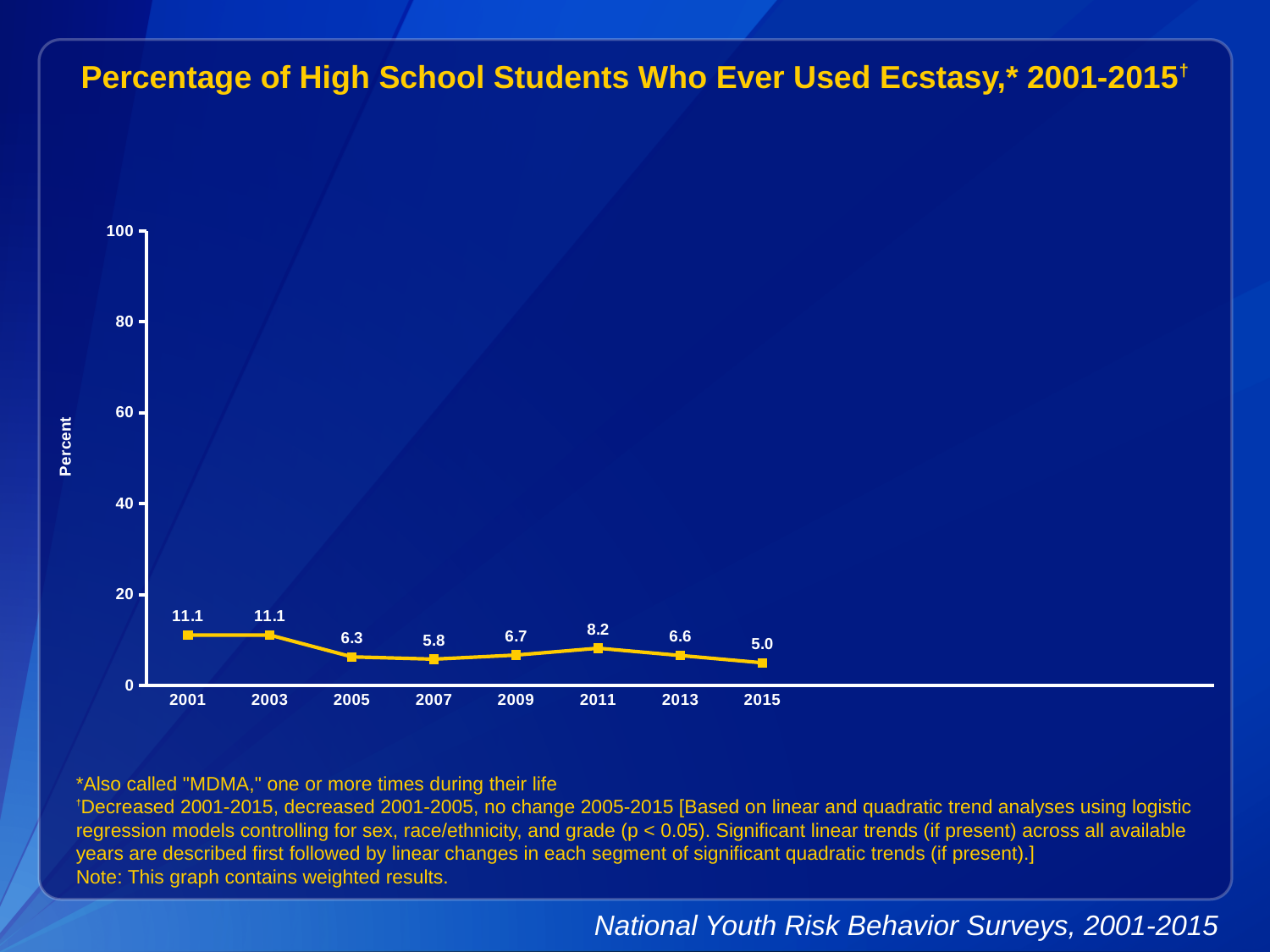
How many years are plotted on the chart? 8 What kind of chart is shown on the slide? line chart What is the difference between the 2011 value and the 2007 value? 2.4 Do the values generally rise or fall from 2001 to 2015? fall What percentage of high school students had ever used ecstasy in 2001? 11.1 What is the label on the vertical axis? Percent What is the difference between the 2001 value and the 2015 value? 6.1 What is the value plotted for 2015? 5.0 What is the value plotted for 2011? 8.2 Which year has the lowest value on the chart? 2015 Which is larger, the value for 2009 or the value for 2013? 2009 Is the value for 2003 greater or less than 20? less